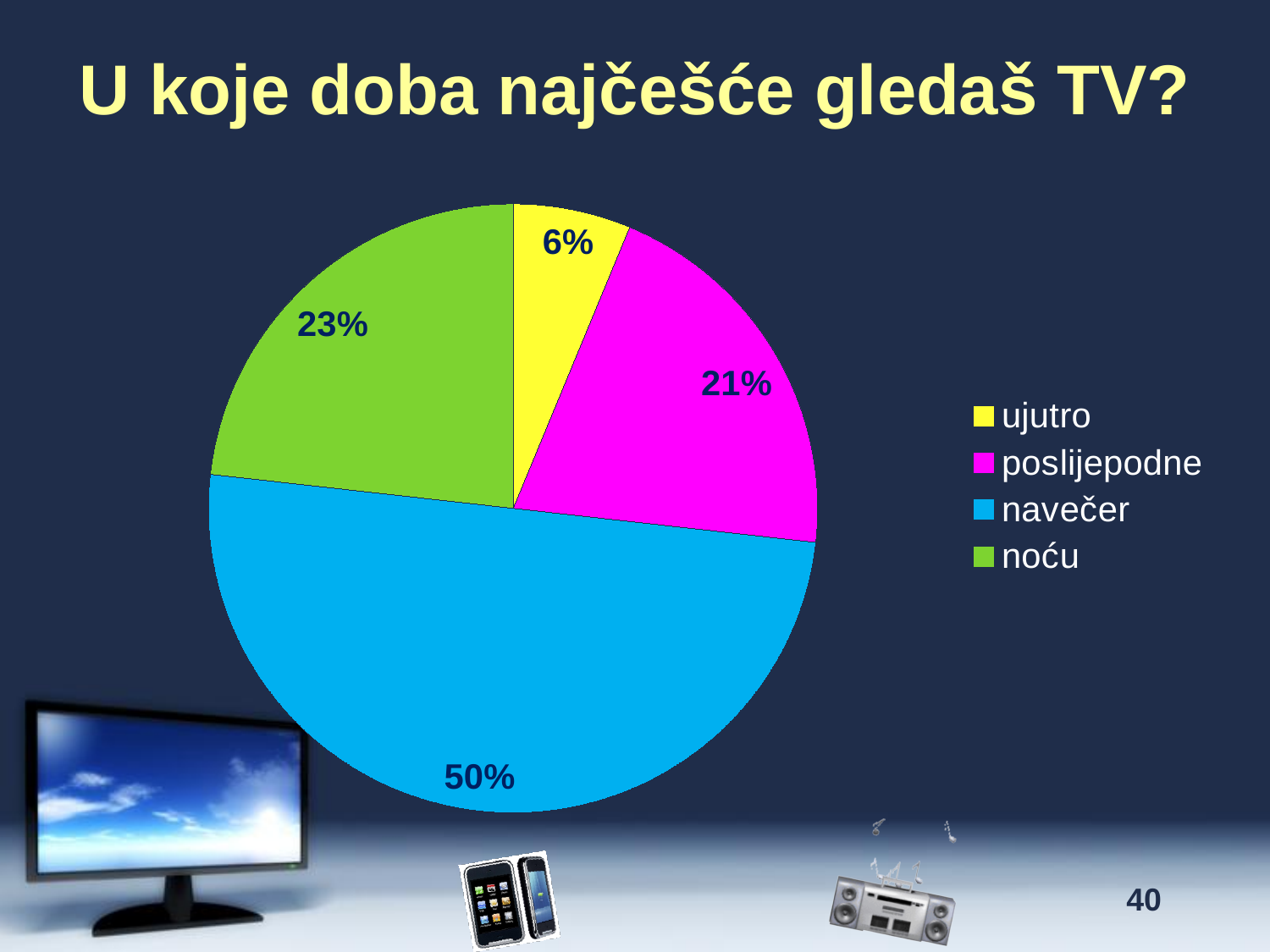
What percentage is shown for ujutro? 6% Which category has the largest slice of the pie? navečer What is the title of the slide containing the chart? U koje doba najčešće gledaš TV? What is the difference in percentage points between navečer and noću? 27 How many categories does the pie chart show? 4 What kind of chart is shown on the slide? pie chart What percentage is shown for noću? 23% Which is larger, the slice for poslijepodne or the slice for ujutro? poslijepodne Which category has the smallest slice of the pie? ujutro What percentage is shown for poslijepodne? 21% What colour is the slice for noću? green What percentage of the pie is labelled for navečer? 50%